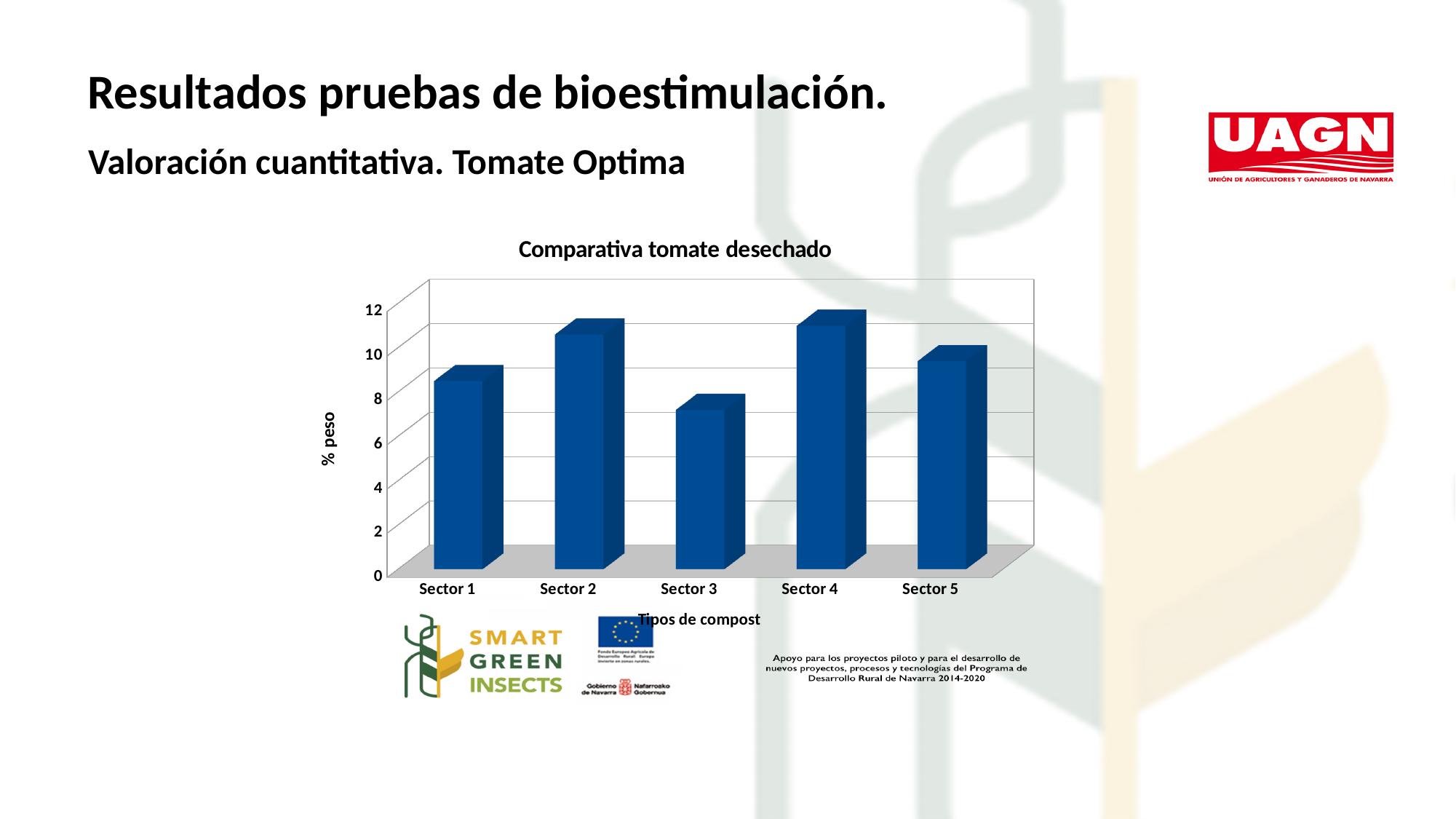
Is the value for Sector 3 greater or less than 8? less What is the label of the vertical axis of the chart? % peso Which sector has the highest value in the chart? Sector 4 How many sectors (categories) are plotted in the chart? 5 Is the value for Sector 1 greater or less than 8? greater Is the value for Sector 2 greater or less than 10? greater What is the title of the chart? Comparativa tomate desechado Which has a larger value, Sector 2 or Sector 3? Sector 2 Which has a larger value, Sector 1 or Sector 5? Sector 5 Which sector has the lowest value in the chart? Sector 3 What type of chart is shown on the slide? Bar chart